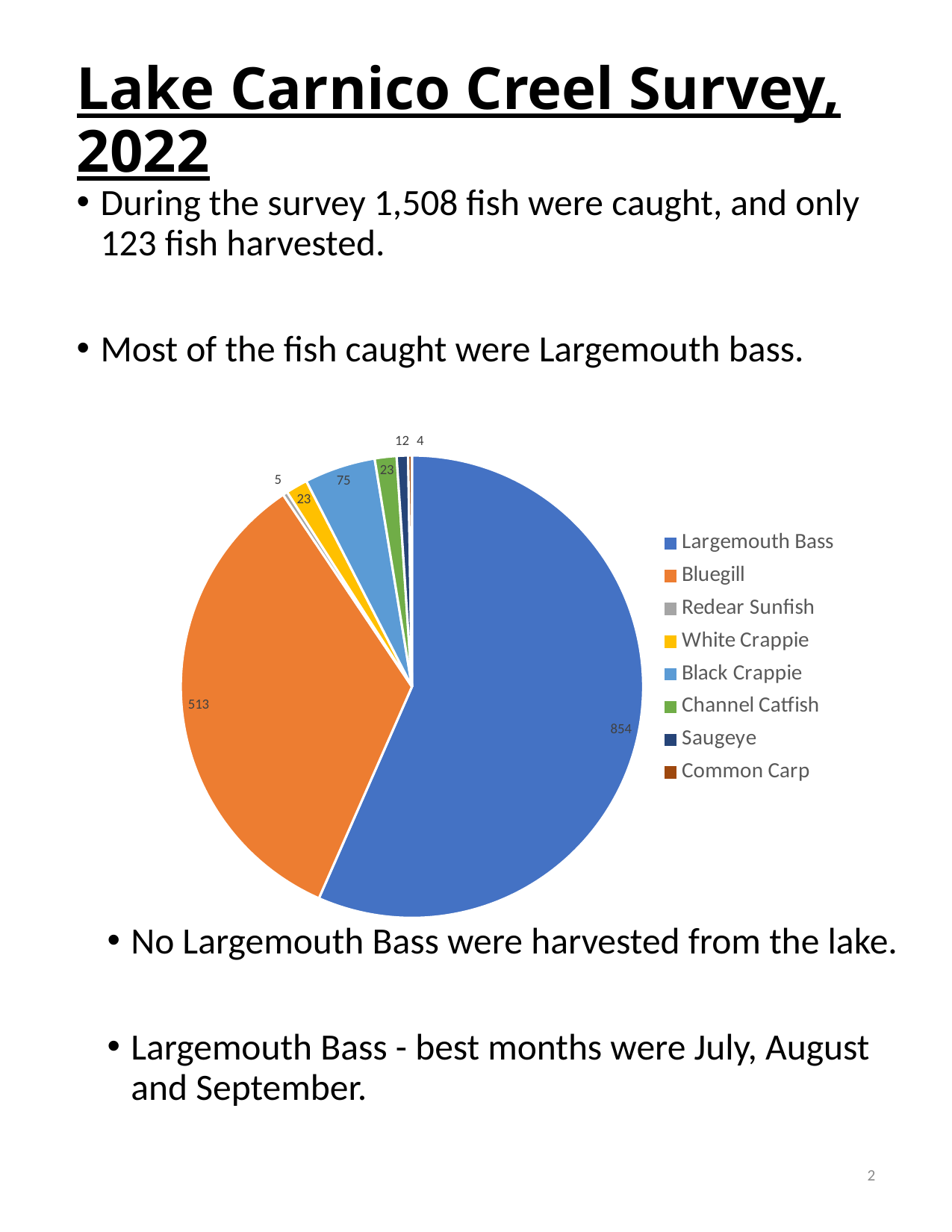
What colour is the Bluegill slice in the pie chart? orange How many fish species (slices) does the pie chart show? 8 What is the value shown for Black Crappie in the pie chart? 75 Which species has the smallest slice in the pie chart? Common Carp What type of chart is shown on the slide? pie chart Which species has the largest slice in the pie chart? Largemouth Bass What is the difference between the Largemouth Bass value and the Bluegill value in the pie chart? 341 What is the value shown for Bluegill in the pie chart? 513 What is the value shown for Saugeye in the pie chart? 12 Which is larger in the pie chart, Black Crappie or Channel Catfish? Black Crappie How many entries does the legend of the pie chart list? 8 What is the value shown for Largemouth Bass in the pie chart? 854